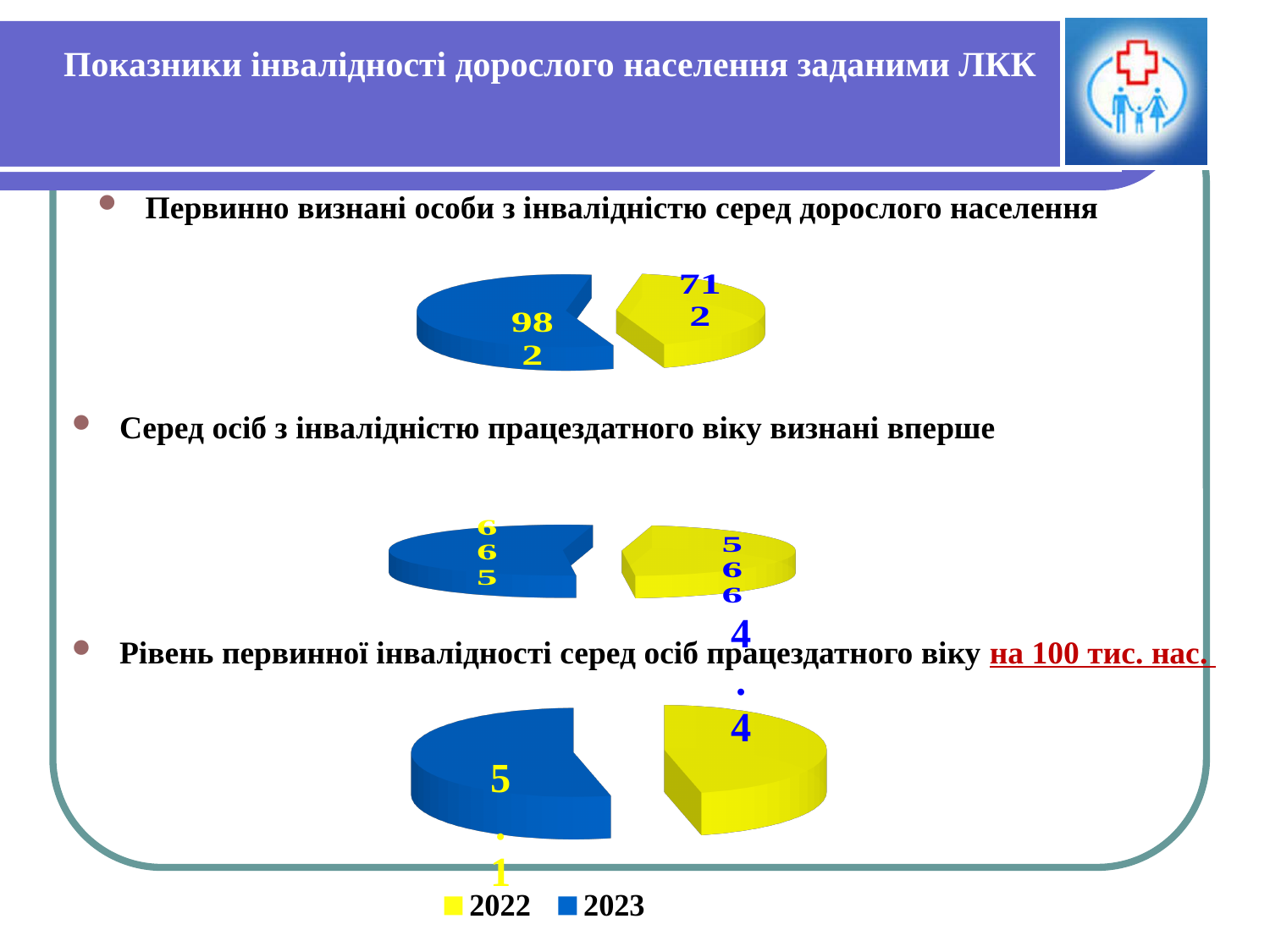
In the middle chart (Серед осіб з інвалідністю працездатного віку визнані вперше), what is the value for 2023? 665 In the middle chart (Серед осіб з інвалідністю працездатного віку визнані вперше), what is the value for 2022? 566 In the bottom chart (Рівень первинної інвалідності серед осіб працездатного віку на 100 тис. нас.), what is the value for 2023? 5.1 According to the legend, which colour represents 2022? Yellow In the top chart (Первинно визнані особи з інвалідністю серед дорослого населення), what is the value for 2022? 712 In the top chart (Первинно визнані особи з інвалідністю серед дорослого населення), what is the value for 2023? 982 How many years does the legend at the bottom of the slide list? 2 In the bottom chart (Рівень первинної інвалідності серед осіб працездатного віку на 100 тис. нас.), what is the value for 2022? 4.4 In the top chart (Первинно визнані особи з інвалідністю серед дорослого населення), what is the difference between the 2023 and 2022 values? 270 In the bottom chart (Рівень первинної інвалідності серед осіб працездатного віку на 100 тис. нас.), which year has the highest value? 2023 In the middle chart (Серед осіб з інвалідністю працездатного віку визнані вперше), which year has the larger value, 2022 or 2023? 2023 What kind of chart is used for the top chart (Первинно визнані особи з інвалідністю серед дорослого населення)? Pie chart